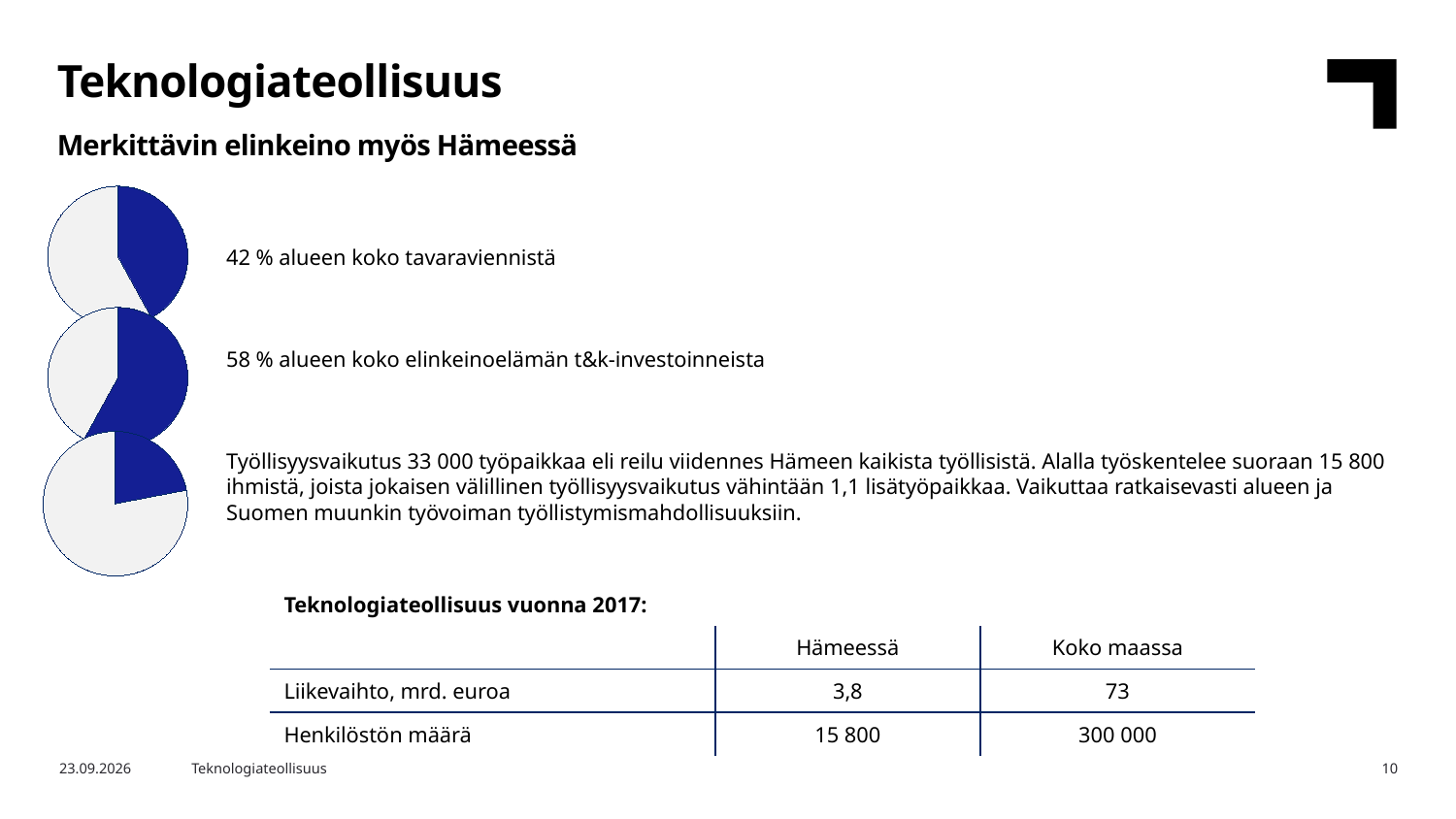
Which of the three pie charts has the smallest blue slice? The bottom one (työllisyysvaikutus) Is the blue slice in the bottom pie chart greater or less than half of the pie? Less How many pie charts are on the slide? 3 In the top pie chart, what share does the blue slice represent (alueen koko tavaravienti)? 42 % What does the top pie chart represent according to the text next to it? Alueen koko tavaravienti (42 %) What colour is used for the highlighted slice in the pie charts? Blue What is the difference in percentage points between the blue shares of the middle pie chart (58 %) and the top pie chart (42 %)? 16 percentage points Is the blue slice larger in the top pie chart or in the middle pie chart? Middle pie chart In the middle pie chart, what share does the blue slice represent (alueen koko elinkeinoelämän t&k-investoinnit)? 58 % In the top pie chart, what share does the grey (non-highlighted) part represent? 58 % What kind of charts are shown on the left side of the slide? Pie charts Which of the three pie charts has the largest blue slice? The middle one (58 % t&k-investoinneista)